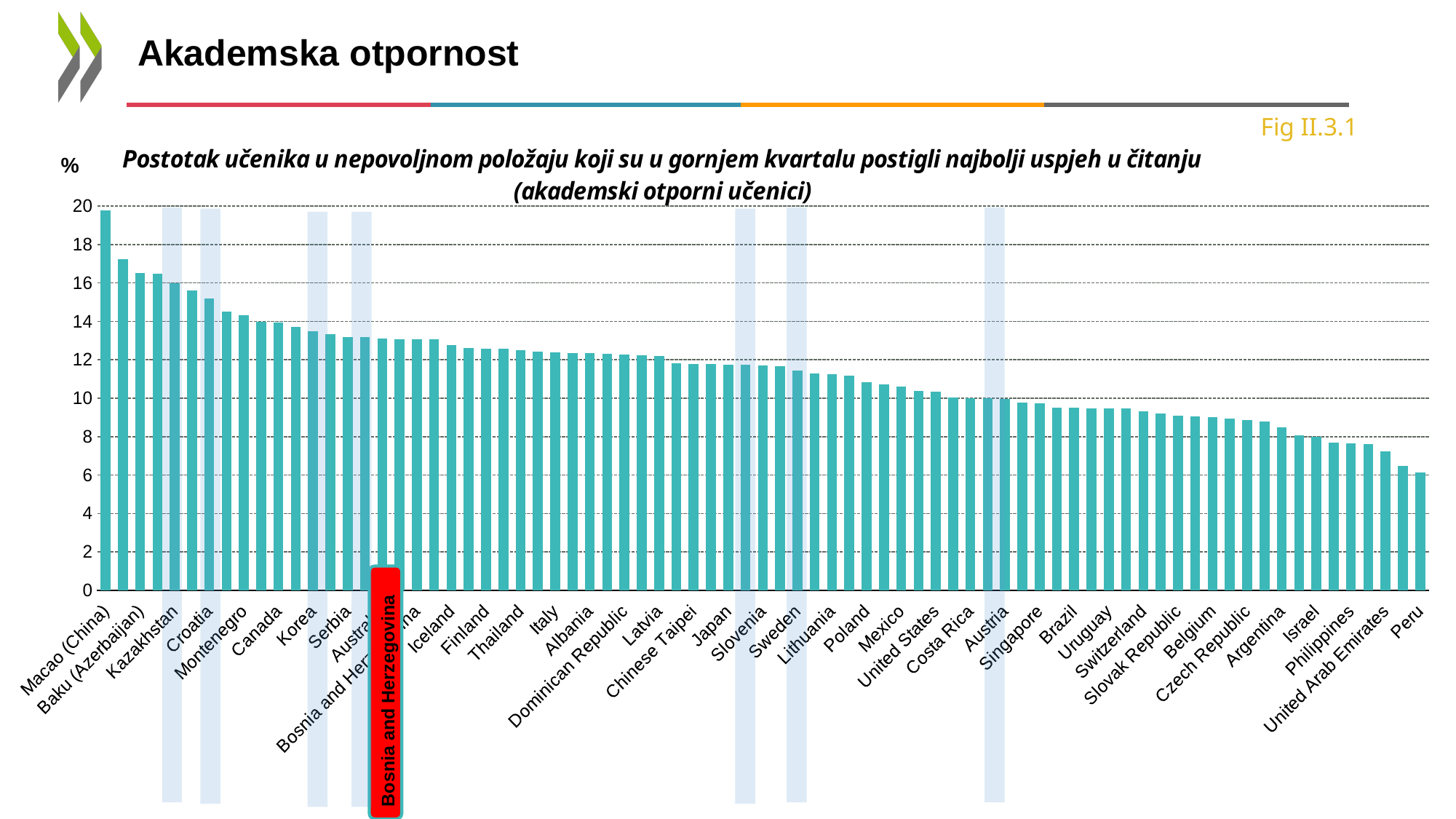
What kind of chart is shown on the slide? bar chart Is the value for Austria greater or less than 12? less Is the value for Croatia greater or less than 14? greater Which country has the highest percentage of academically resilient students? Macao (China) Which has a larger value, Peru or Macao (China)? Macao (China) Is the value for Peru greater or less than 8? less What figure number is given in the top right corner of the slide? Fig II.3.1 Which country has the lowest percentage of academically resilient students? Peru Which has a larger value, Croatia or Austria? Croatia Do the values rise or fall moving from left to right along the x axis? fall